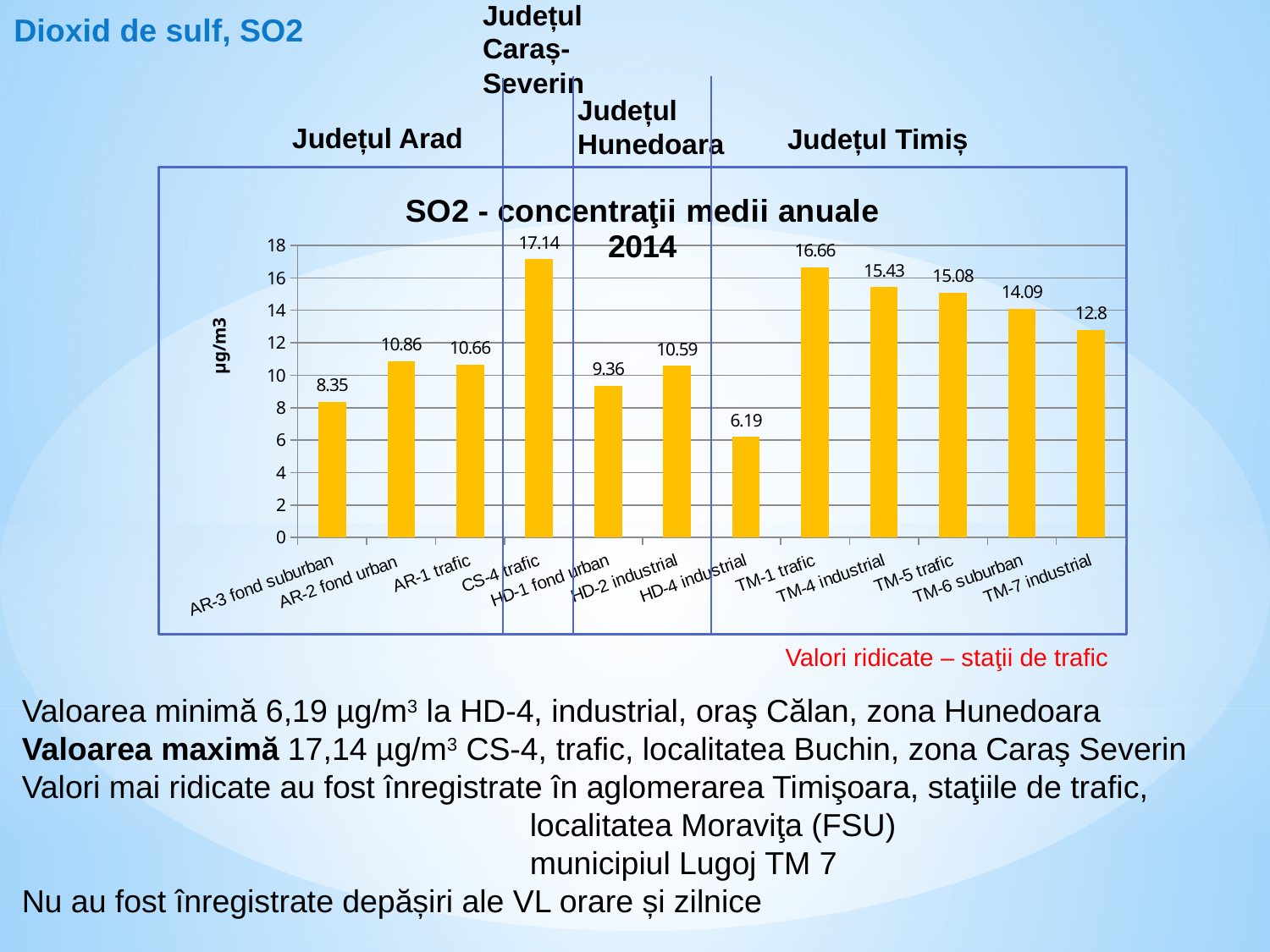
How many stations (bars) are shown in the chart? 12 What is the difference between the values for CS-4 trafic and HD-4 industrial? 10.95 Which station has the highest SO2 annual mean concentration? CS-4 trafic Which station has the lowest SO2 annual mean concentration? HD-4 industrial What is the value for AR-3 fond suburban? 8.35 What is the value for CS-4 trafic? 17.14 What is the value for HD-4 industrial? 6.19 What unit is shown on the vertical axis of the chart? µg/m3 Is the value for TM-7 industrial greater or less than 12? greater What is the value for TM-1 trafic? 16.66 Which is larger, the value for TM-4 industrial or the value for TM-5 trafic? TM-4 industrial What type of chart is shown? Bar chart